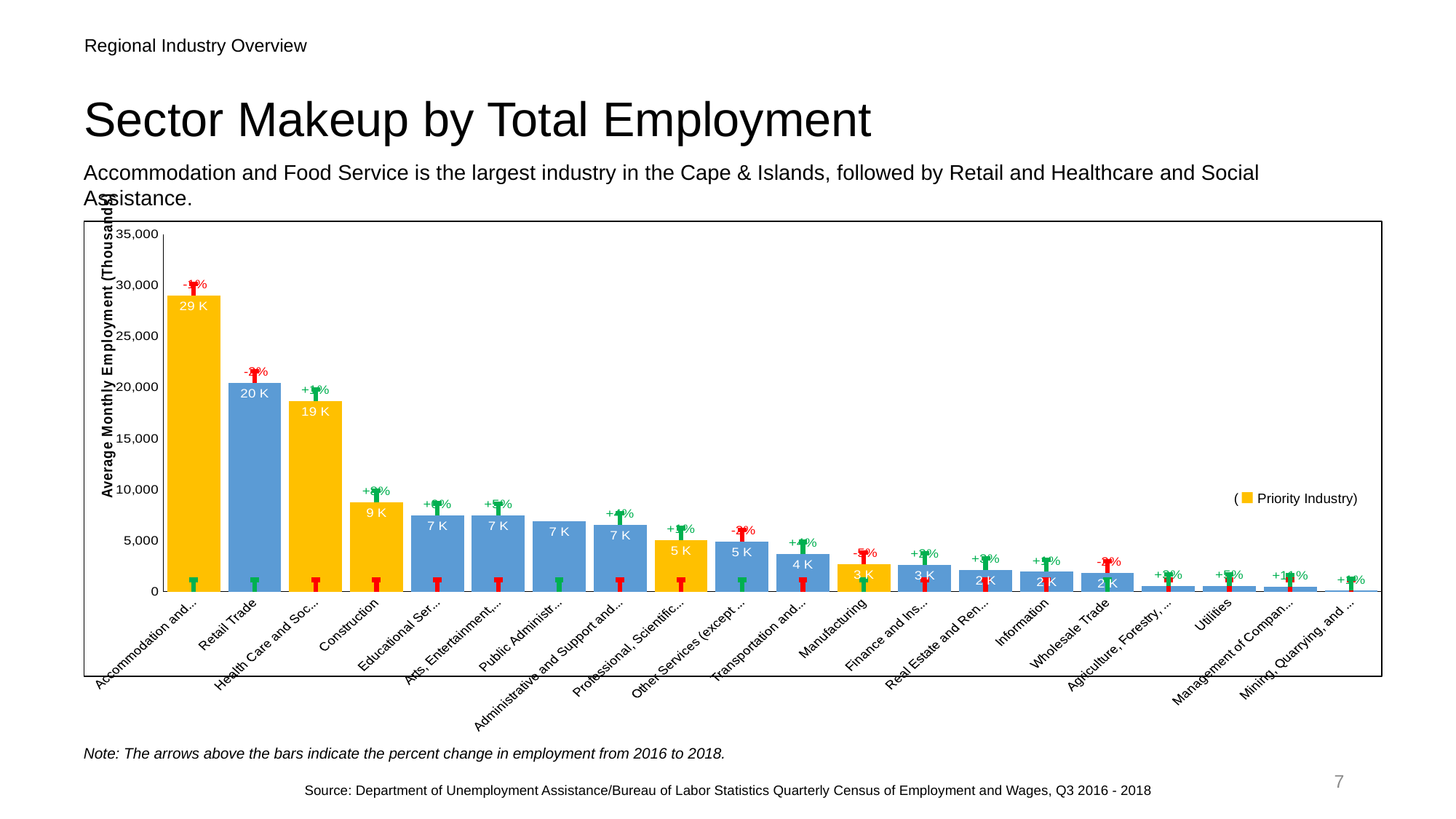
Which has a larger value, Construction or Manufacturing? Construction What kind of chart is shown on the slide? bar chart What is the difference between the labelled values for Retail Trade and Health Care and Soc...? 1 K What is the title of the y axis? Average Monthly Employment (Thousands) How many industry categories are plotted on the x axis? 20 What value is labelled on the Manufacturing bar? 3 K Is the value for Accommodation and Food Service greater or less than 25,000? greater Is the value for Utilities greater or less than 5,000? less What value is labelled on the Construction bar? 9 K Which industry has the lowest average monthly employment? Mining, Quarrying, and ... What is the average monthly employment value shown for Retail Trade? 20 K Which industry has the highest average monthly employment? Accommodation and Food Service